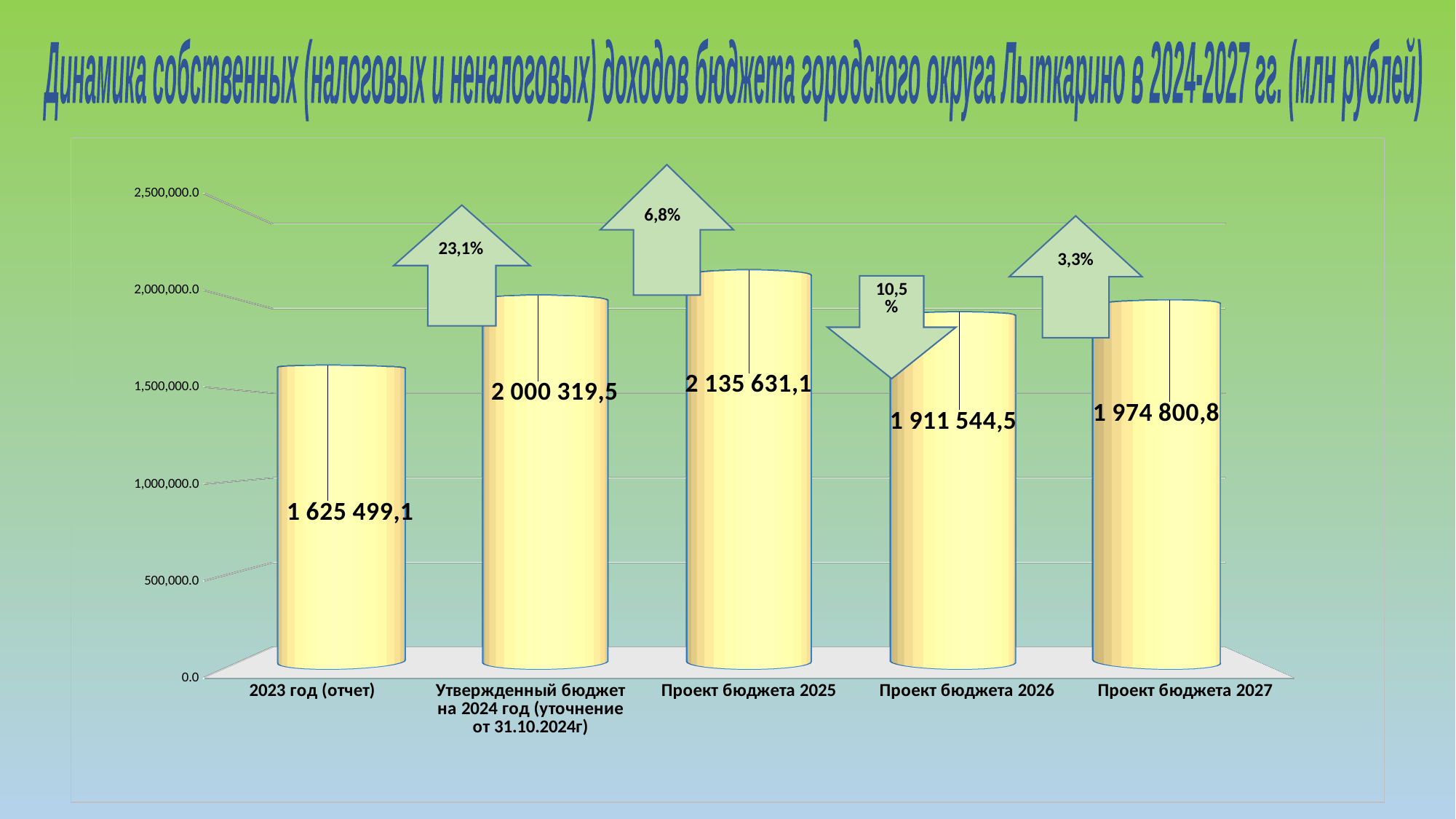
What is the difference between the values for Проект бюджета 2027 and Проект бюджета 2026? 63 256,3 Which category has the lowest value? 2023 год (отчет) How many categories are shown on the chart? 5 What kind of chart is shown on the slide? Bar chart What is the value for Утвержденный бюджет на 2024 год (уточнение от 31.10.2024г)? 2 000 319,5 What is the value for 2023 год (отчет)? 1 625 499,1 Which is larger: the value for Проект бюджета 2026 or Проект бюджета 2027? Проект бюджета 2027 What is the value for Проект бюджета 2027? 1 974 800,8 What is the value for Проект бюджета 2025? 2 135 631,1 What percentage change is shown in the arrow between Утвержденный бюджет на 2024 год and Проект бюджета 2025? 6,8% What is the difference between the values for Проект бюджета 2025 and Утвержденный бюджет на 2024 год? 135 311,6 Which category has the highest value? Проект бюджета 2025